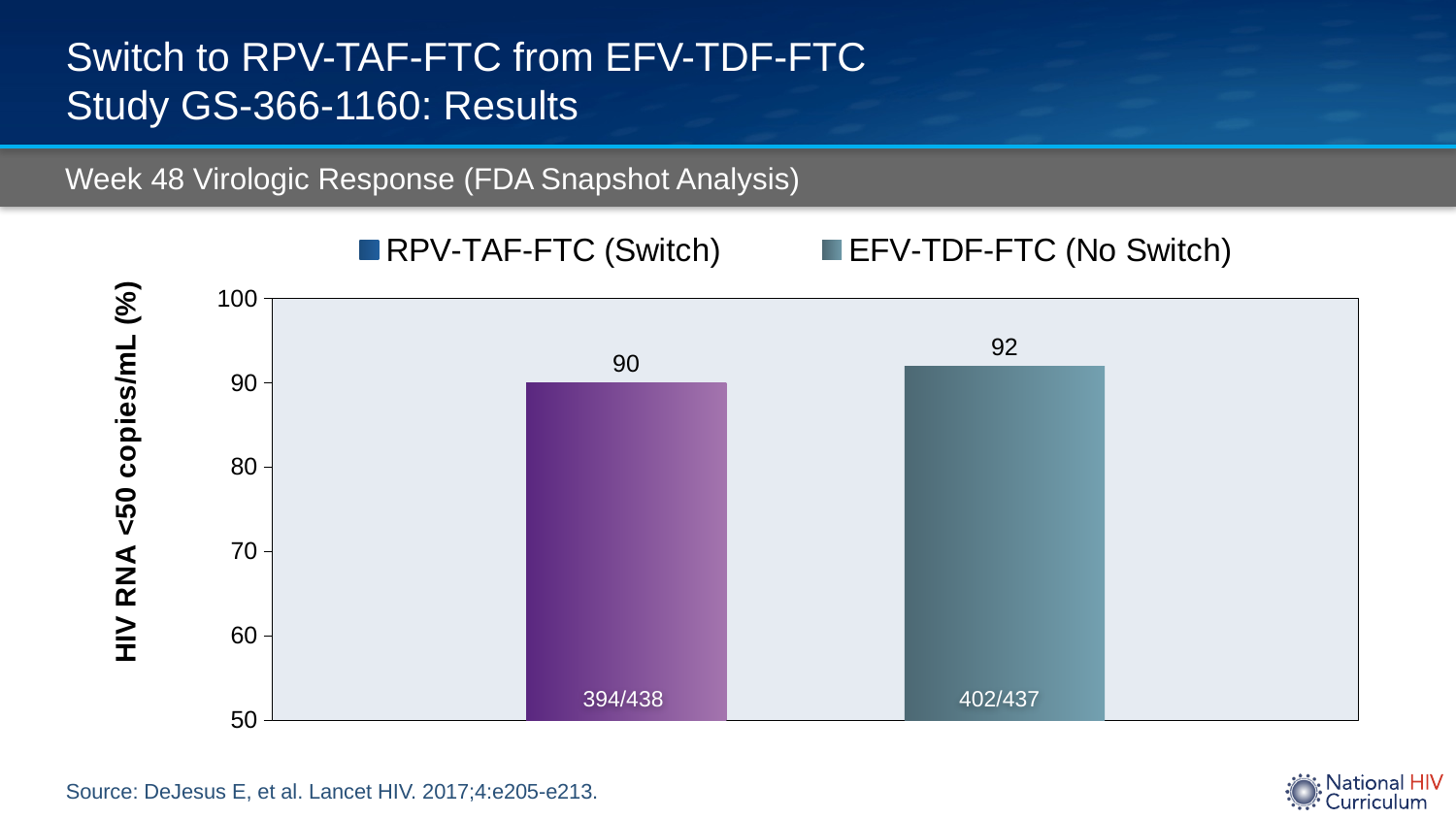
What is the difference between the EFV-TDF-FTC (No Switch) value and the RPV-TAF-FTC (Switch) value? 2 Is the value for RPV-TAF-FTC (Switch) greater or less than 80? greater How many bars are plotted in the chart? 2 What is the y-axis label of the chart? HIV RNA <50 copies/mL (%) How many series does the legend list? 2 What is the value for RPV-TAF-FTC (Switch)? 90 What is the value for EFV-TDF-FTC (No Switch)? 92 What fraction is printed inside the RPV-TAF-FTC (Switch) bar? 394/438 Which series has the higher value, RPV-TAF-FTC (Switch) or EFV-TDF-FTC (No Switch)? EFV-TDF-FTC (No Switch) Which series has the lowest value? RPV-TAF-FTC (Switch) Is the value for EFV-TDF-FTC (No Switch) greater or less than 100? less What kind of chart is shown? Bar chart